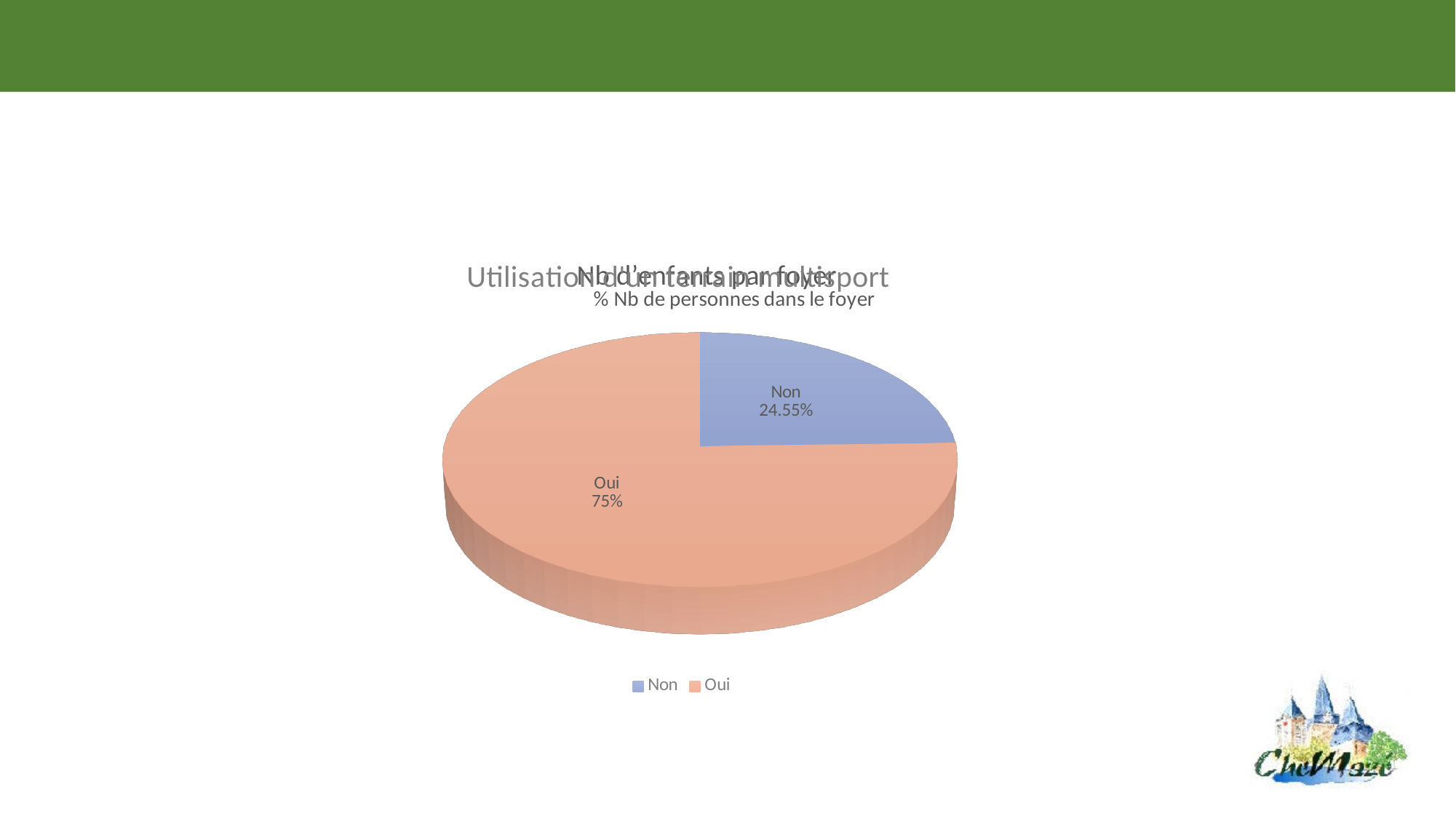
What share of the pie does the "Non" slice represent? 24.55% How many entries does the legend of the chart list? 2 What is the difference between the "Oui" and "Non" percentages shown on the pie chart? 50.45% What percentage is shown for the "Oui" slice of the pie chart? 75% What colour is the "Oui" slice in the pie chart? Orange What kind of chart is shown on the slide? Pie chart Which slice of the pie chart is the smallest? Non How many slices does the pie chart have? 2 What percentage is shown for the "Non" slice of the pie chart? 24.55% Which slice of the pie chart is the largest? Oui What colour is the "Non" slice in the pie chart? Blue Which is larger in the pie chart, the "Oui" slice or the "Non" slice? Oui